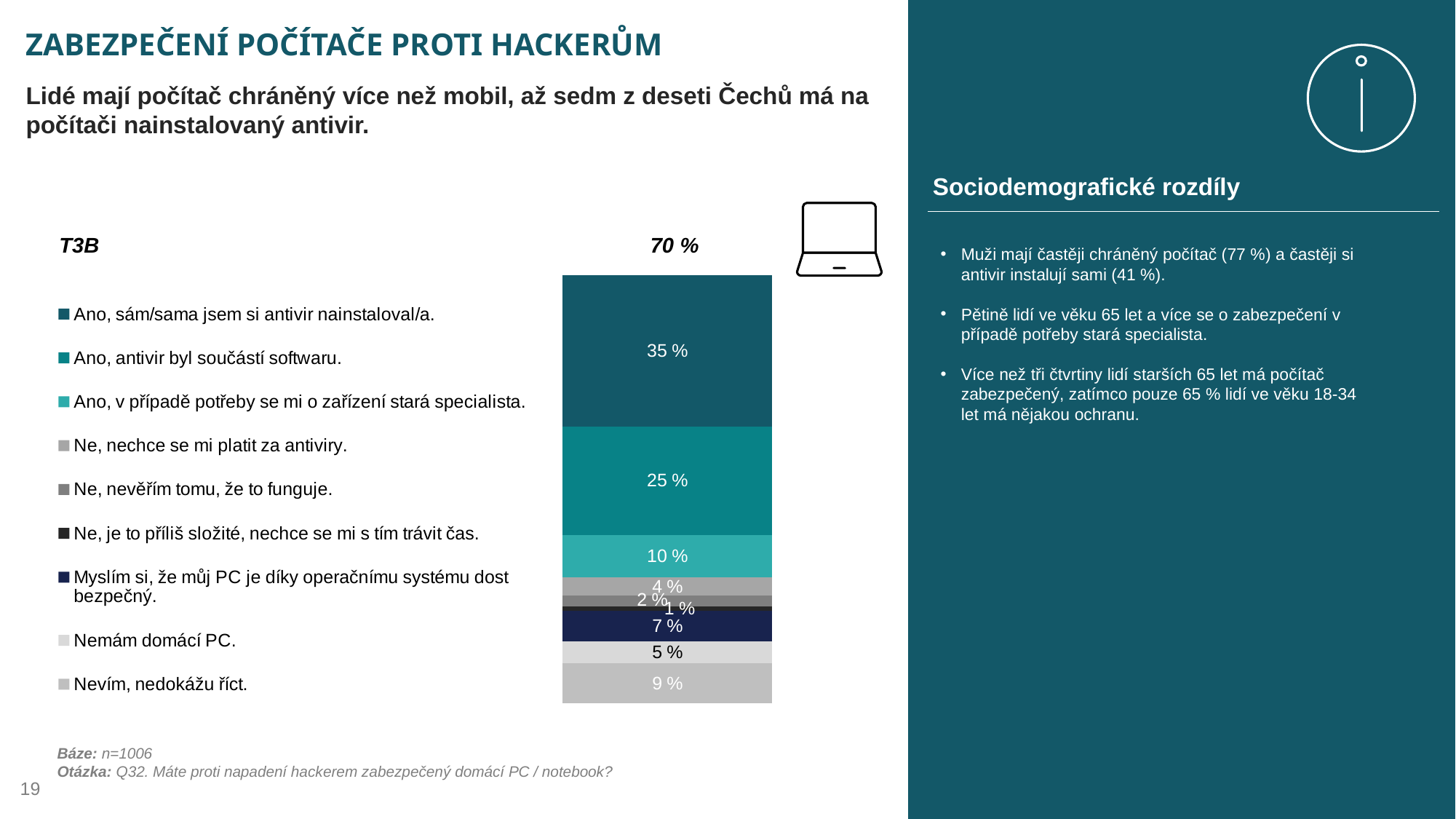
Which is larger: the share who do not want to pay for antivirus ("Ne, nechce se mi platit za antiviry.") or the share who do not have a home PC? Nemám domácí PC. Which legend category has the largest segment in the stacked bar? Ano, sám/sama jsem si antivir nainstaloval/a. What percentage of respondents said the antivirus was part of the software ("Ano, antivir byl součástí softwaru.")? 25 % What is the difference between the share who installed the antivirus themselves and the share for whom the antivirus was part of the software? 10 % What percentage of respondents said a specialist takes care of their device when needed ("Ano, v případě potřeby se mi o zařízení stará specialista.")? 10 % Which legend category has the smallest segment in the stacked bar? Ne, je to příliš složité, nechce se mi s tím trávit čas. What percentage of respondents said they think their PC is secure enough thanks to the operating system? 7 % What percentage of respondents said they do not have a home PC ("Nemám domácí PC.")? 5 % What percentage of respondents answered "Nevím, nedokážu říct."? 9 % How many categories does the legend of the chart list? 9 What is the T3B value shown above the stacked bar? 70 % What percentage of respondents said they installed the antivirus themselves ("Ano, sám/sama jsem si antivir nainstaloval/a.")? 35 %